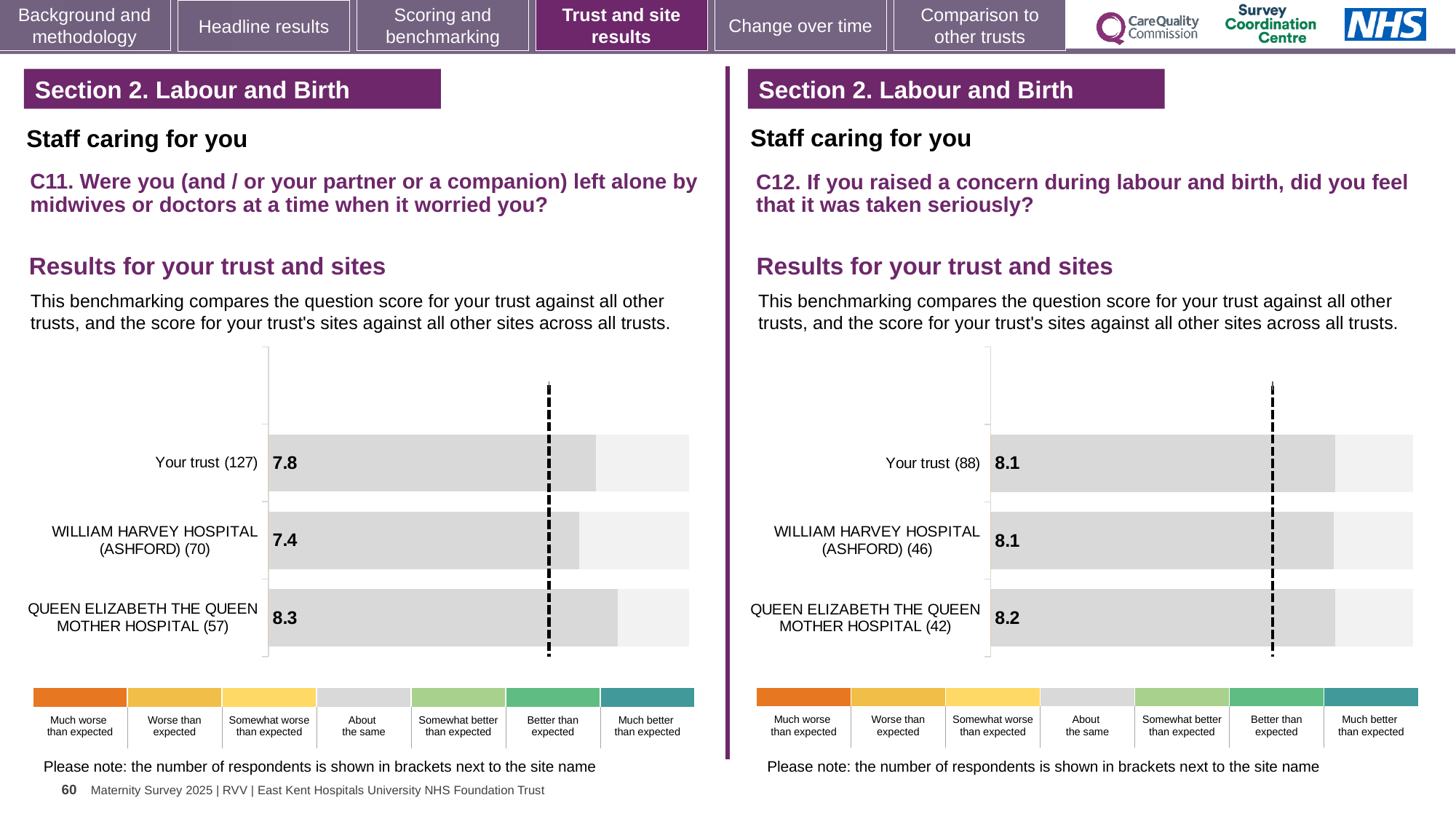
On the C11 chart (left), what is the difference between the scores for QUEEN ELIZABETH THE QUEEN MOTHER HOSPITAL and WILLIAM HARVEY HOSPITAL (ASHFORD)? 0.9 On the C12 chart (right), which site has the higher score, WILLIAM HARVEY HOSPITAL (ASHFORD) or QUEEN ELIZABETH THE QUEEN MOTHER HOSPITAL? QUEEN ELIZABETH THE QUEEN MOTHER HOSPITAL On the C11 chart (left), which site or trust has the lowest score? WILLIAM HARVEY HOSPITAL (ASHFORD) On the C11 chart (left), what is the score for Your trust? 7.8 What kind of chart is used on the C11 chart (left)? Bar chart On the C12 chart (right), how many respondents are shown in brackets for WILLIAM HARVEY HOSPITAL (ASHFORD)? 46 On the C11 chart (left), how many respondents are shown in brackets for Your trust? 127 On the C11 chart (left), what is the score for WILLIAM HARVEY HOSPITAL (ASHFORD)? 7.4 On the C12 chart (right), what is the score for Your trust? 8.1 On the C11 chart (left), which site or trust has the highest score? QUEEN ELIZABETH THE QUEEN MOTHER HOSPITAL On the C12 chart (right), what is the score for QUEEN ELIZABETH THE QUEEN MOTHER HOSPITAL? 8.2 On the C12 chart (right), how many bars are plotted? 3